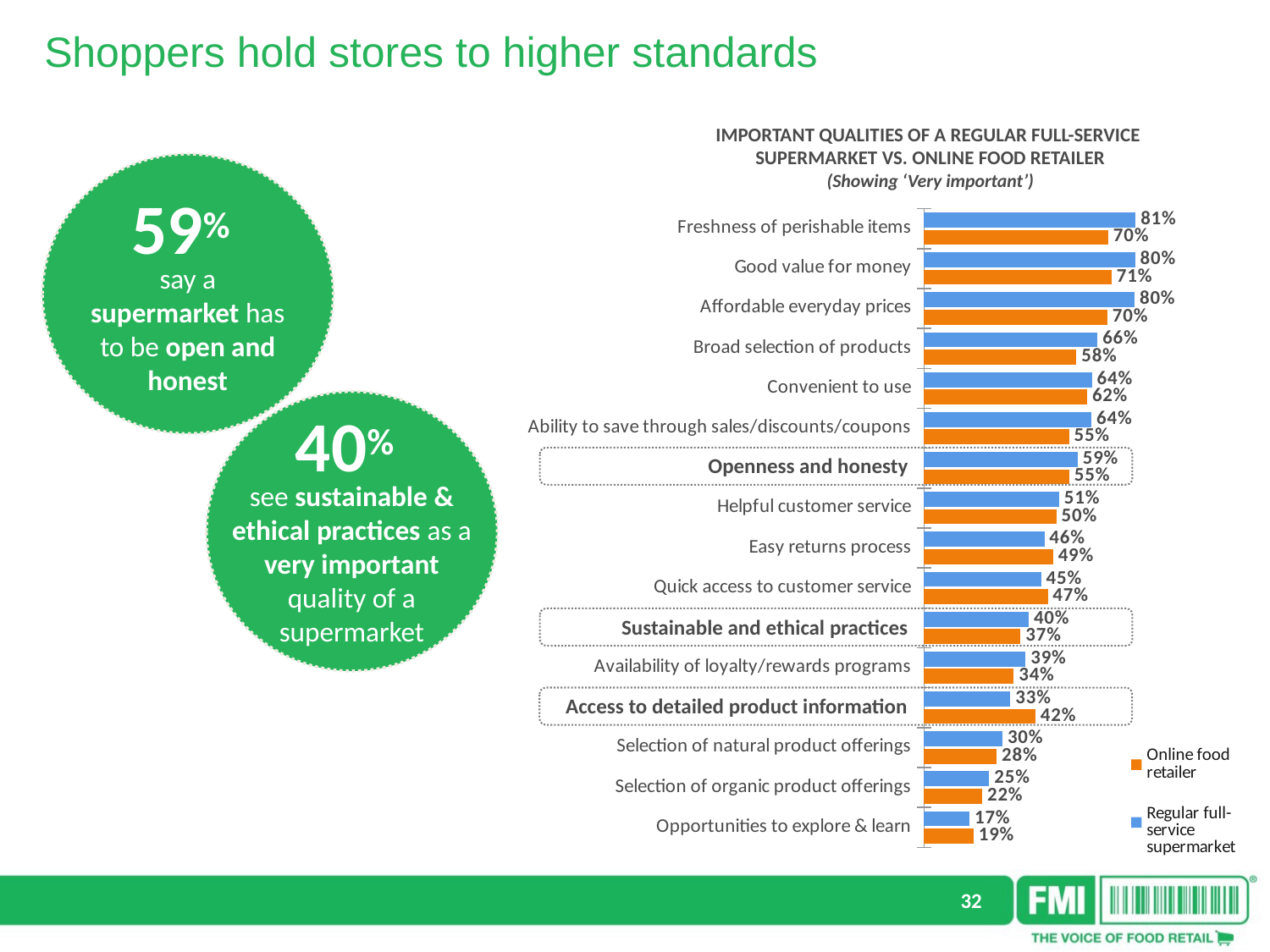
What is the value for 'Access to detailed product information' for the online food retailer series? 42% Which quality has the highest value for the regular full-service supermarket? Freshness of perishable items What type of chart is shown on the slide? Bar chart What percentage of shoppers rate 'Freshness of perishable items' as very important for a regular full-service supermarket? 81% How many qualities are listed on the chart? 16 Which quality has the lowest value for the online food retailer? Opportunities to explore & learn What is the value for 'Selection of organic product offerings' for the online food retailer? 22% Which colour represents the online food retailer series in the chart? Orange For 'Easy returns process', which is larger: the regular full-service supermarket value or the online food retailer value? Online food retailer How many series does the legend list? 2 What is the difference between the supermarket and online food retailer values for 'Ability to save through sales/discounts/coupons'? 9 percentage points What is the value for 'Openness and honesty' for the regular full-service supermarket? 59%